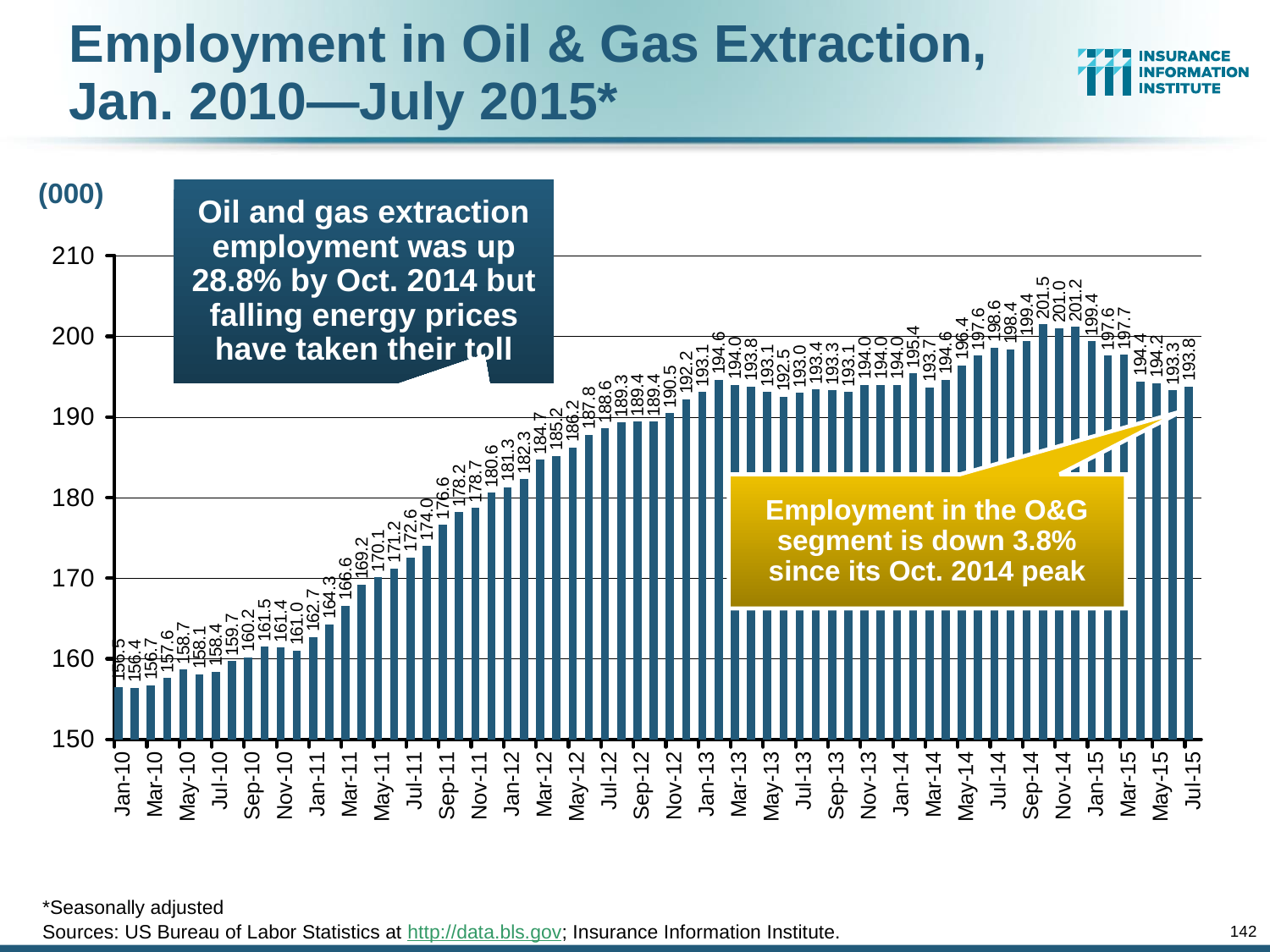
Is the value for Jan-10 greater or less than 160? less Is the value for Jul-15 greater or less than 190? greater Do the values generally rise or fall from Jan-10 to Oct-14? rise Which is larger, the value for Jan-10 or the value for Jul-15? Jul-15 What was employment in oil & gas extraction in Jan-10? 156.5 By how much did employment fall from its Oct. 2014 peak (201.5) to Jul-15 (193.8)? 7.7 According to the callout, by what percentage is employment in the O&G segment down since its Oct. 2014 peak? 3.8% In what units are the values on the y-axis expressed? (000) What was employment in oil & gas extraction in Jul-15, the last month shown? 193.8 What is the highest value shown on the chart? 201.5 What kind of chart is shown on the slide? bar chart In which month did oil & gas extraction employment peak? Oct. 2014